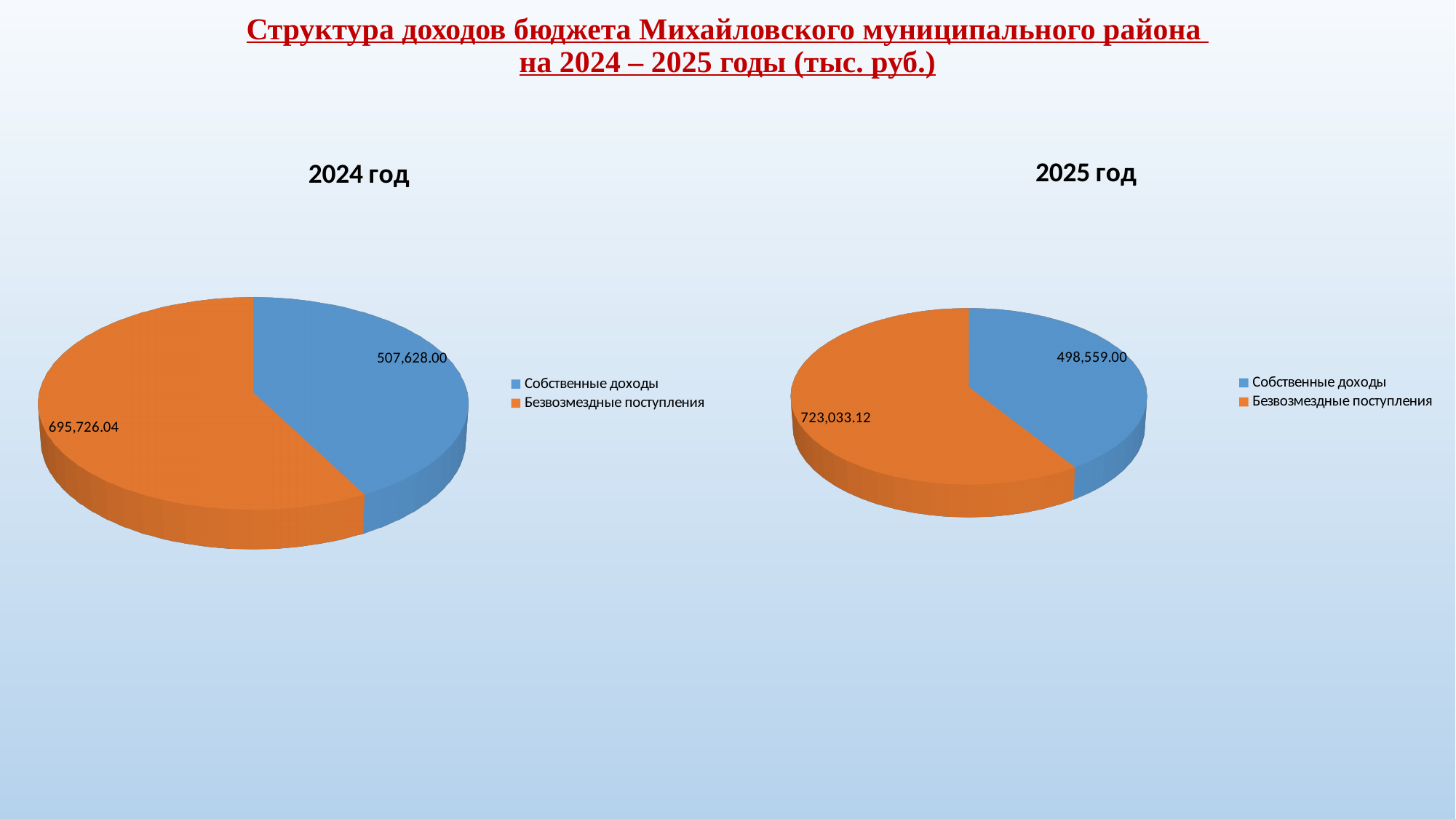
In the 2025 год chart, what is the value for Безвозмездные поступления? 723,033.12 In the 2024 год chart, what is the value for Собственные доходы? 507,628.00 In the 2024 год chart, which category has the largest slice? Безвозмездные поступления What type of chart is the 2024 год chart? Pie chart How many slices does the 2025 год chart have? 2 In the 2025 год chart, what is the value for Собственные доходы? 498,559.00 In the 2025 год chart, what is the difference between Безвозмездные поступления and Собственные доходы? 224,474.12 In the 2024 год chart, what is the difference between Безвозмездные поступления and Собственные доходы? 188,098.04 In the 2024 год chart, what is the value for Безвозмездные поступления? 695,726.04 In the 2025 год chart, what colour is the Безвозмездные поступления slice? Orange Is the value for Собственные доходы larger in the 2024 год chart or in the 2025 год chart? 2024 год In the 2025 год chart, which category has the smallest slice? Собственные доходы